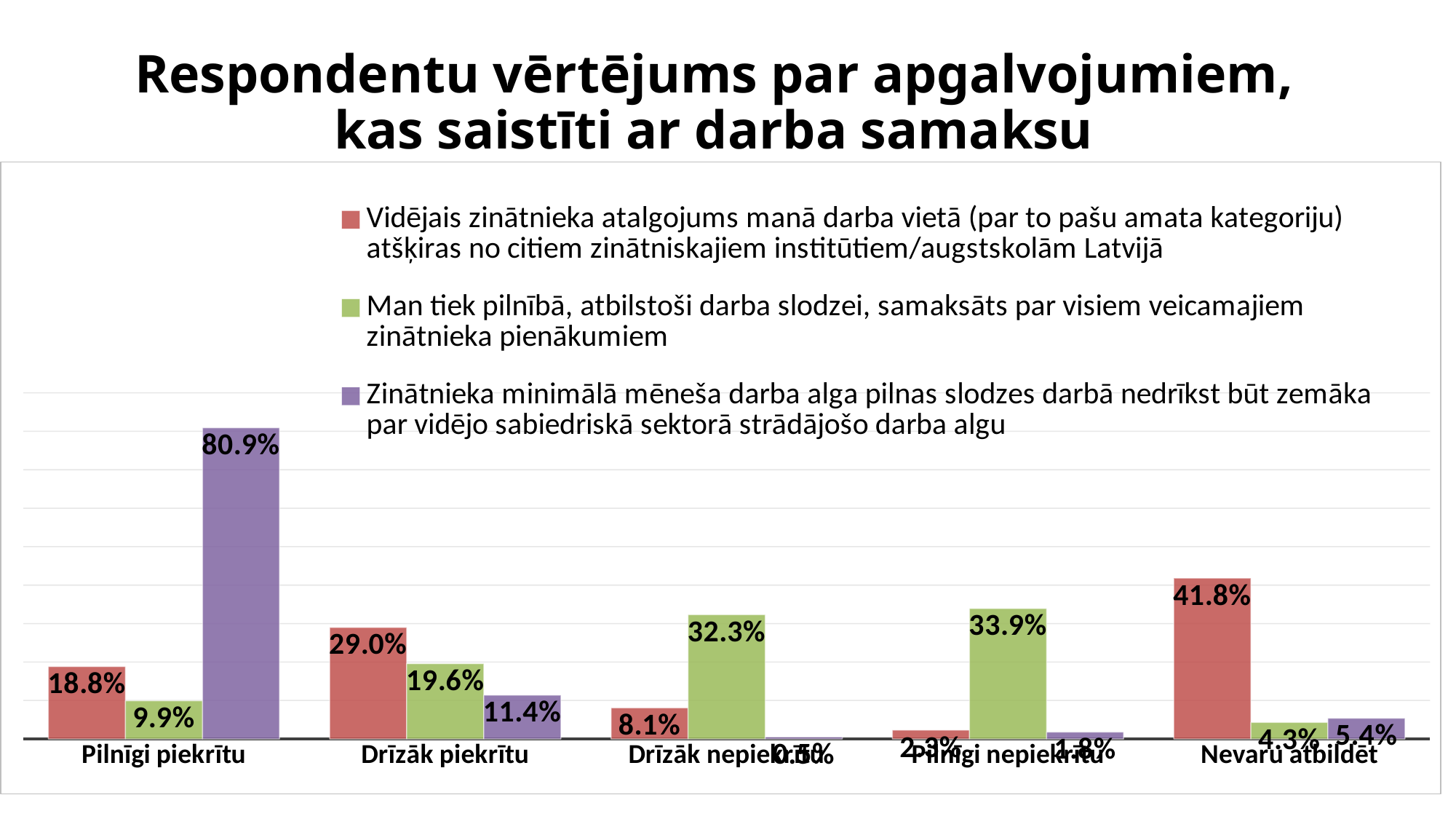
How many series does the legend list? 3 What is the value of the red series (Vidējais zinātnieka atalgojums...) for 'Nevaru atbildēt'? 41.8% Which category has the highest value for the red series (Vidējais zinātnieka atalgojums...)? Nevaru atbildēt What is the title of the slide? Respondentu vērtējums par apgalvojumiem, kas saistīti ar darba samaksu What is the difference between the red series value for 'Drīzāk piekrītu' (29.0%) and the green series value for the same category (19.6%)? 9.4% What is the value of the green series (Man tiek pilnībā... samaksāts) for 'Pilnīgi nepiekrītu'? 33.9% What kind of chart is shown on the slide? bar chart Which category has the lowest value for the green series (Man tiek pilnībā... samaksāts)? Nevaru atbildēt What is the value of the green series for 'Drīzāk piekrītu'? 19.6% For 'Drīzāk nepiekrītu', which is larger: the red series value or the green series value? the green series (32.3%) What is the value of the purple series (Zinātnieka minimālā mēneša darba alga...) for 'Pilnīgi piekrītu'? 80.9% How many response categories are shown on the x axis? 5